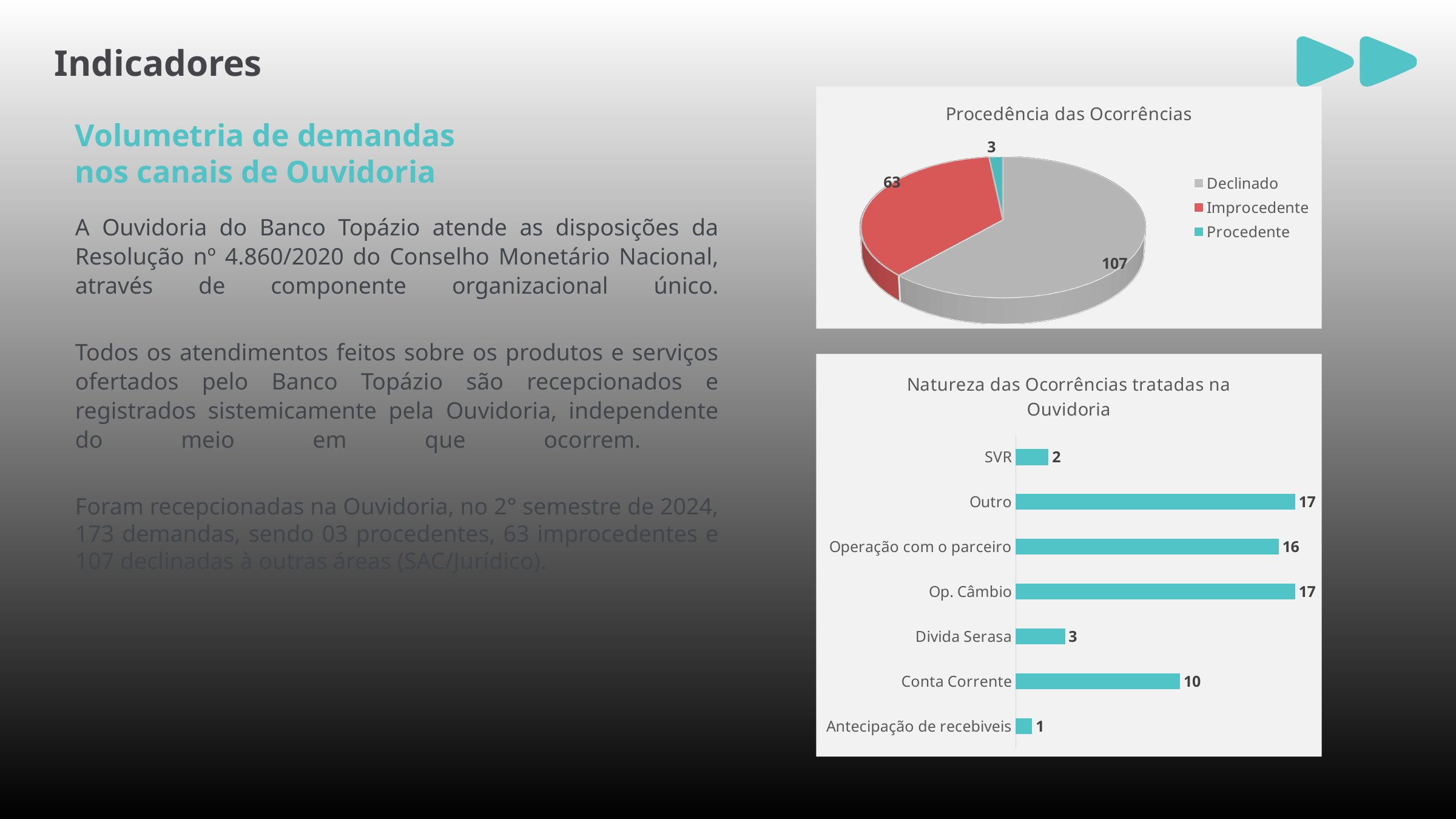
In the 'Natureza das Ocorrências tratadas na Ouvidoria' chart, what is the value for Operação com o parceiro? 16 In the 'Natureza das Ocorrências tratadas na Ouvidoria' chart, how many categories are shown? 7 In the 'Procedência das Ocorrências' pie chart, what is the value for Improcedente? 63 In the 'Natureza das Ocorrências tratadas na Ouvidoria' chart, which category has the lowest value? Antecipação de recebiveis In the 'Natureza das Ocorrências tratadas na Ouvidoria' chart, what is the value for Conta Corrente? 10 In the 'Procedência das Ocorrências' pie chart, what is the value for Declinado? 107 In the 'Procedência das Ocorrências' chart, what colour is the Improcedente slice? Red In the 'Natureza das Ocorrências tratadas na Ouvidoria' chart, which is larger: Conta Corrente or Divida Serasa? Conta Corrente In the 'Procedência das Ocorrências' pie chart, what is the difference between Declinado and Improcedente? 44 In the 'Procedência das Ocorrências' pie chart, which category has the smallest slice? Procedente What kind of chart is 'Natureza das Ocorrências tratadas na Ouvidoria'? Bar chart In the 'Procedência das Ocorrências' pie chart, how many categories does the legend list? 3